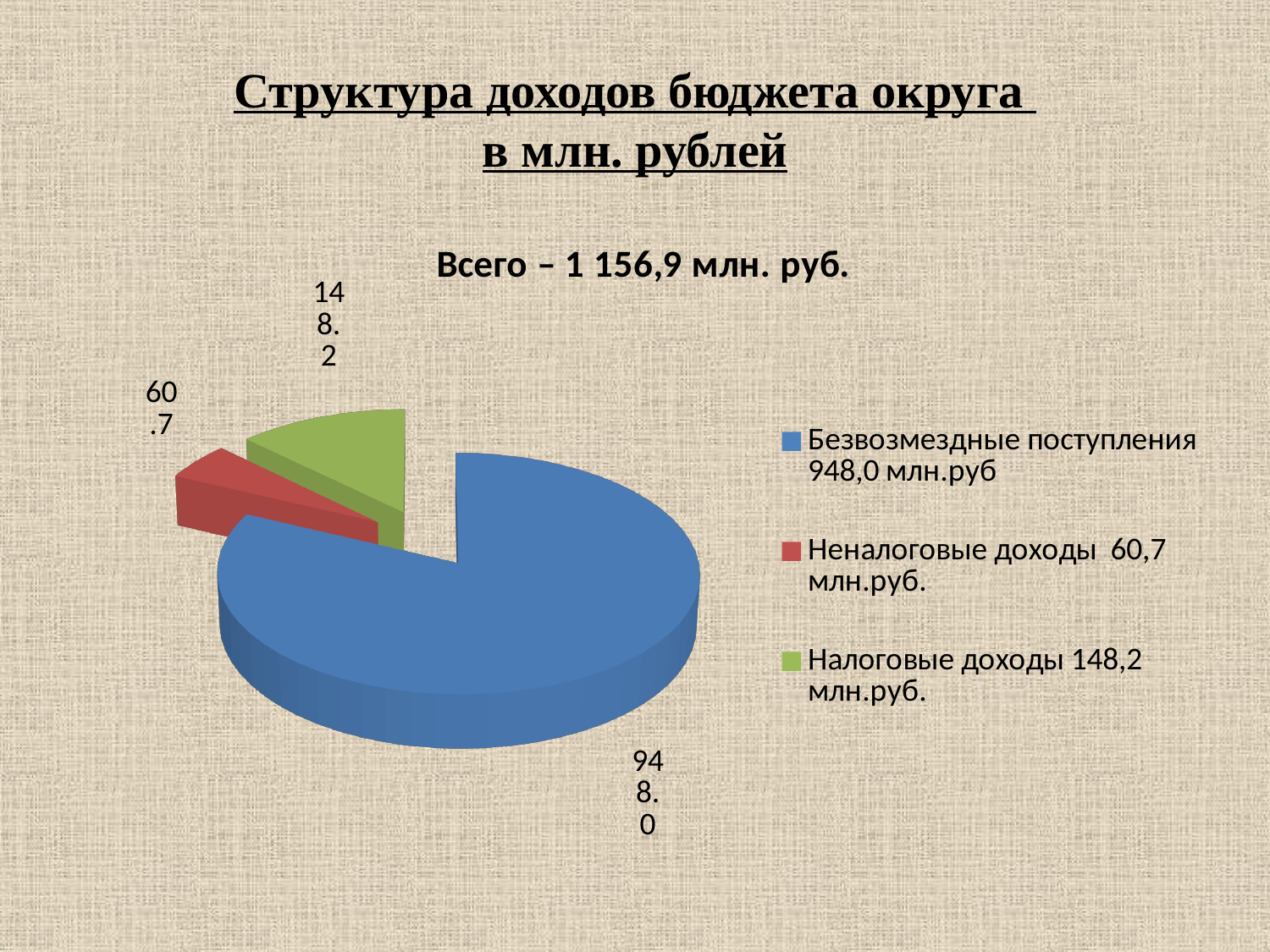
What total amount is stated above the pie chart? 1 156,9 млн. руб. What is the difference between Налоговые доходы and Неналоговые доходы? 87,5 млн.руб. Which category has the largest slice of the pie? Безвозмездные поступления How many categories does the pie chart have? 3 What is the difference between Безвозмездные поступления and Налоговые доходы? 799,8 млн.руб. What is the value for Налоговые доходы? 148,2 млн.руб. What is the value for Безвозмездные поступления? 948,0 млн.руб What type of chart is shown on the slide? Pie chart What is the value for Неналоговые доходы? 60,7 млн.руб. Which category has the smallest slice of the pie? Неналоговые доходы What colour is the slice for Налоговые доходы? Green Which is larger, Налоговые доходы or Неналоговые доходы? Налоговые доходы